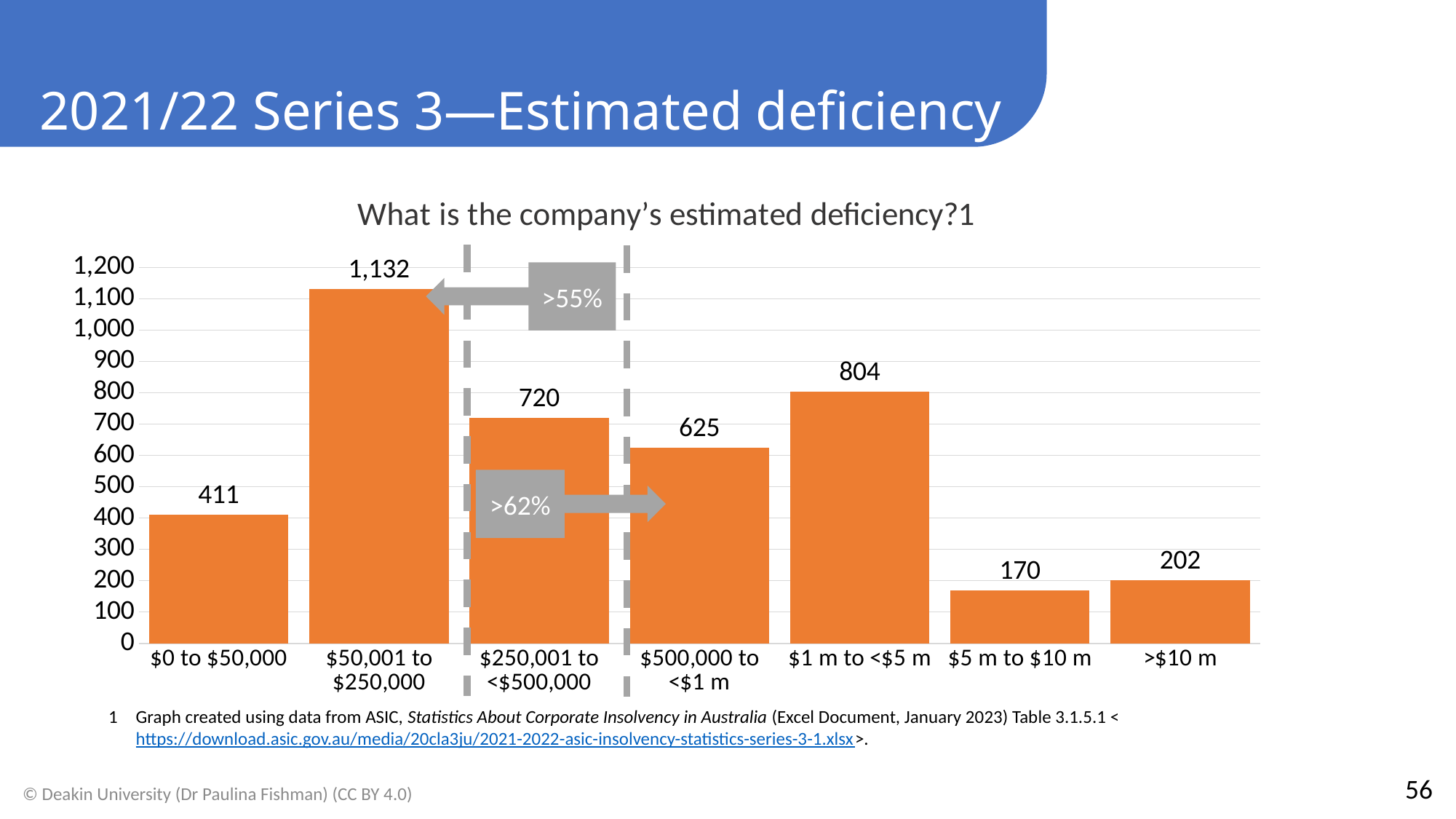
What is the value for the $1 m to <$5 m category? 804 What is the value for the $50,001 to $250,000 category? 1,132 How many categories are shown on the x axis? 7 Is the value for $1 m to <$5 m greater or less than 700? greater What kind of chart is shown on the slide? bar chart What is the title of the chart? What is the company's estimated deficiency? What percentage label is shown in the grey box with the arrow pointing left? >55% Which category has the highest value? $50,001 to $250,000 What is the value for the >$10 m category? 202 Which is larger, the value for $0 to $50,000 or the value for $500,000 to <$1 m? $500,000 to <$1 m Which category has the lowest value? $5 m to $10 m What is the difference between the values for $250,001 to <$500,000 and $500,000 to <$1 m? 95